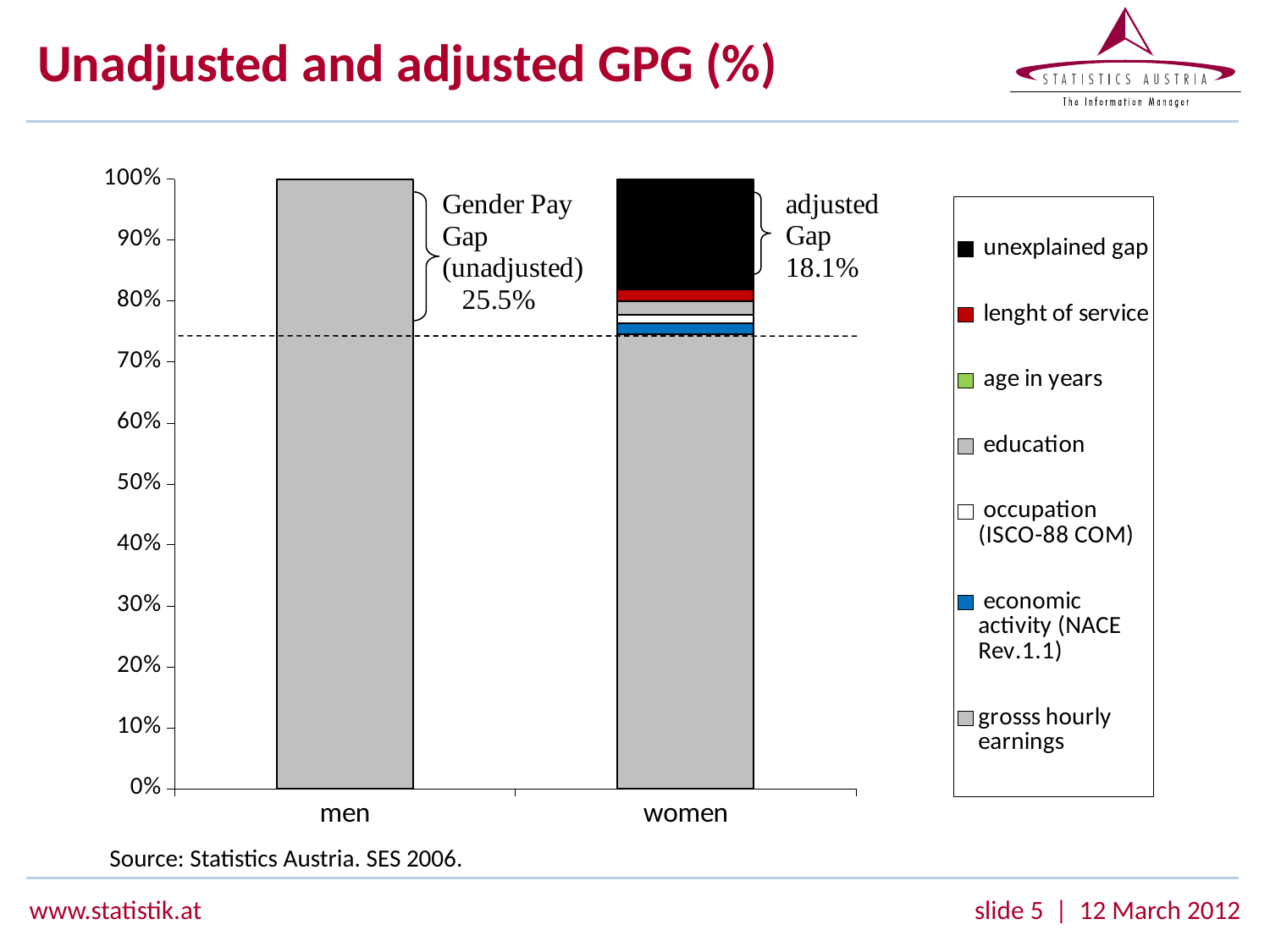
What value does the bar for men reach on the y axis? 100% How many categories are shown on the x axis of the chart? 2 Is the grosss hourly earnings segment for women greater or less than 80%? less What is the unadjusted Gender Pay Gap shown on the chart? 25.5% Is the grosss hourly earnings segment for women greater or less than 70%? greater Which is larger, the unadjusted Gender Pay Gap or the adjusted Gap? unadjusted Gender Pay Gap What colour represents the unexplained gap in the legend? black What is the adjusted Gap shown on the chart? 18.1% Which category has the larger grosss hourly earnings segment, men or women? men How many series does the chart's legend list? 7 What is the difference between the unadjusted Gender Pay Gap and the adjusted Gap? 7.4 percentage points What kind of chart is shown on the slide? bar chart